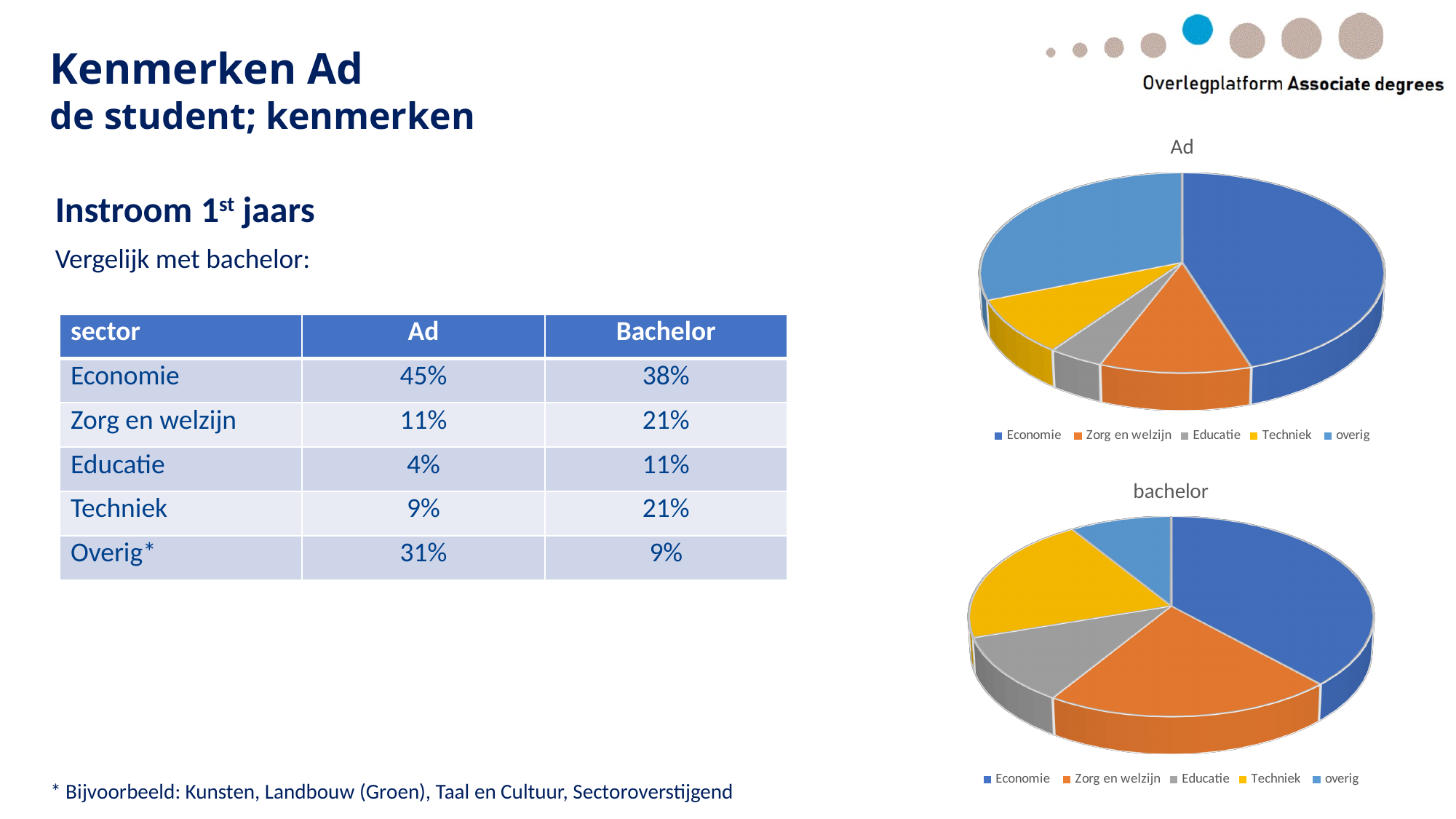
What is the difference between the Economie share in the 'Ad' pie chart and the Economie share in the 'bachelor' pie chart? 7% How many entries does the legend of the 'bachelor' pie chart list? 5 How many slices does the 'Ad' pie chart have? 5 In the 'bachelor' pie chart, which sector has the largest slice? Economie In the 'Ad' pie chart, which sector has the smallest slice? Educatie In the 'Ad' pie chart, is the slice for 'Zorg en welzijn' larger or smaller than the slice for 'Techniek'? Larger What share of the 'Ad' pie chart does the 'overig' slice represent? 31% In the 'Ad' pie chart, which sector has the largest slice? Economie In the 'bachelor' pie chart, which sector has the smallest slice? overig What kind of charts are the two charts on the right of the slide? Pie charts Which colour represents 'Educatie' in the pie charts? Grey What share of the 'bachelor' pie chart does the 'Techniek' slice represent? 21%